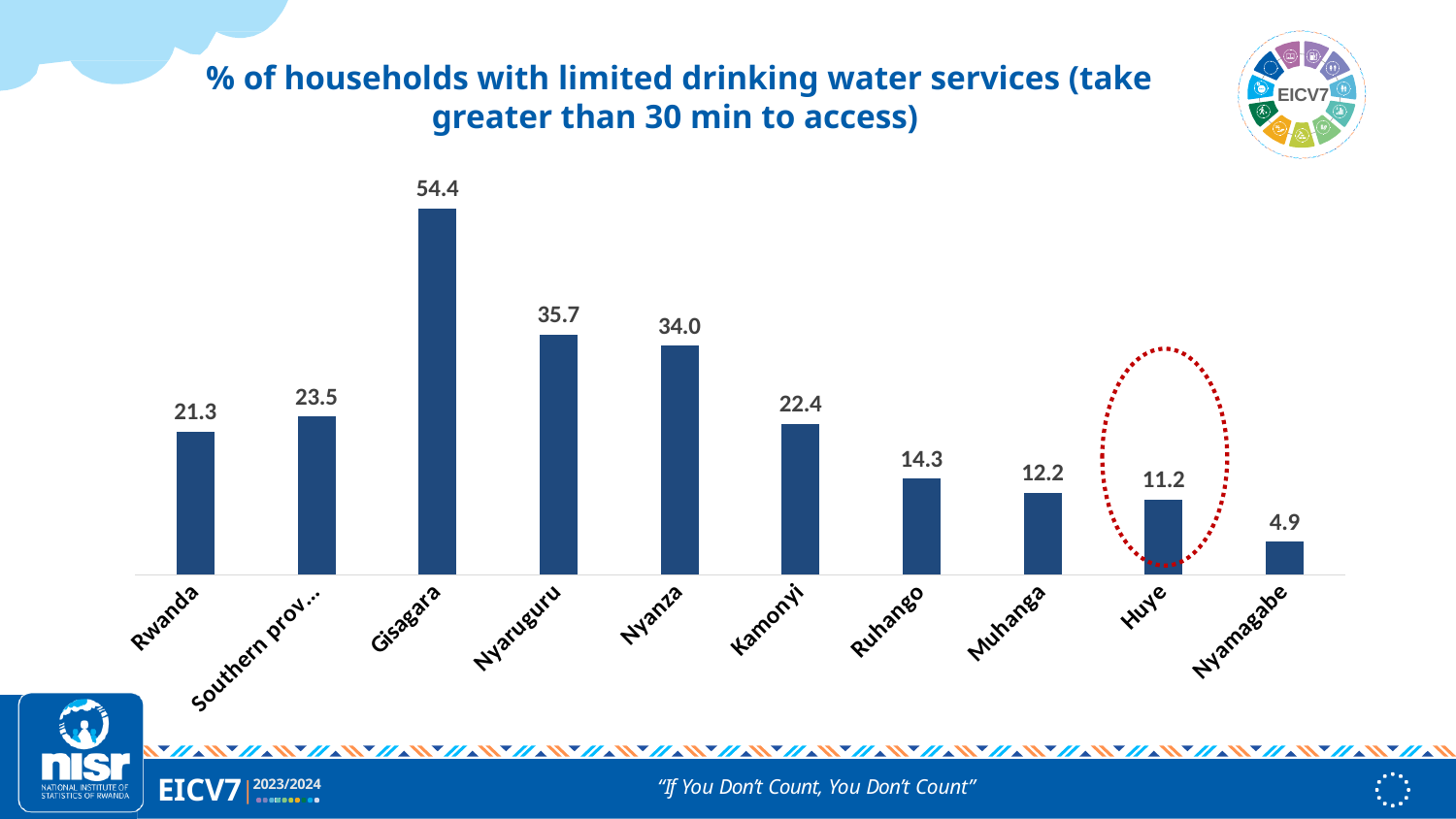
Which is larger, the value for Nyanza or the value for Kamonyi? Nyanza Which category is highlighted with a red dotted circle? Huye What is the value for Rwanda? 21.3 What kind of chart is shown on the slide? Bar chart Which category has the lowest value? Nyamagabe What is the title of the chart? % of households with limited drinking water services (take greater than 30 min to access) What is the difference between the values for Ruhango and Muhanga? 2.1 What is the value for Huye? 11.2 What is the value for Gisagara? 54.4 How many categories are shown on the x axis? 10 What is the difference between the values for Gisagara and Nyaruguru? 18.7 Which category has the highest value? Gisagara